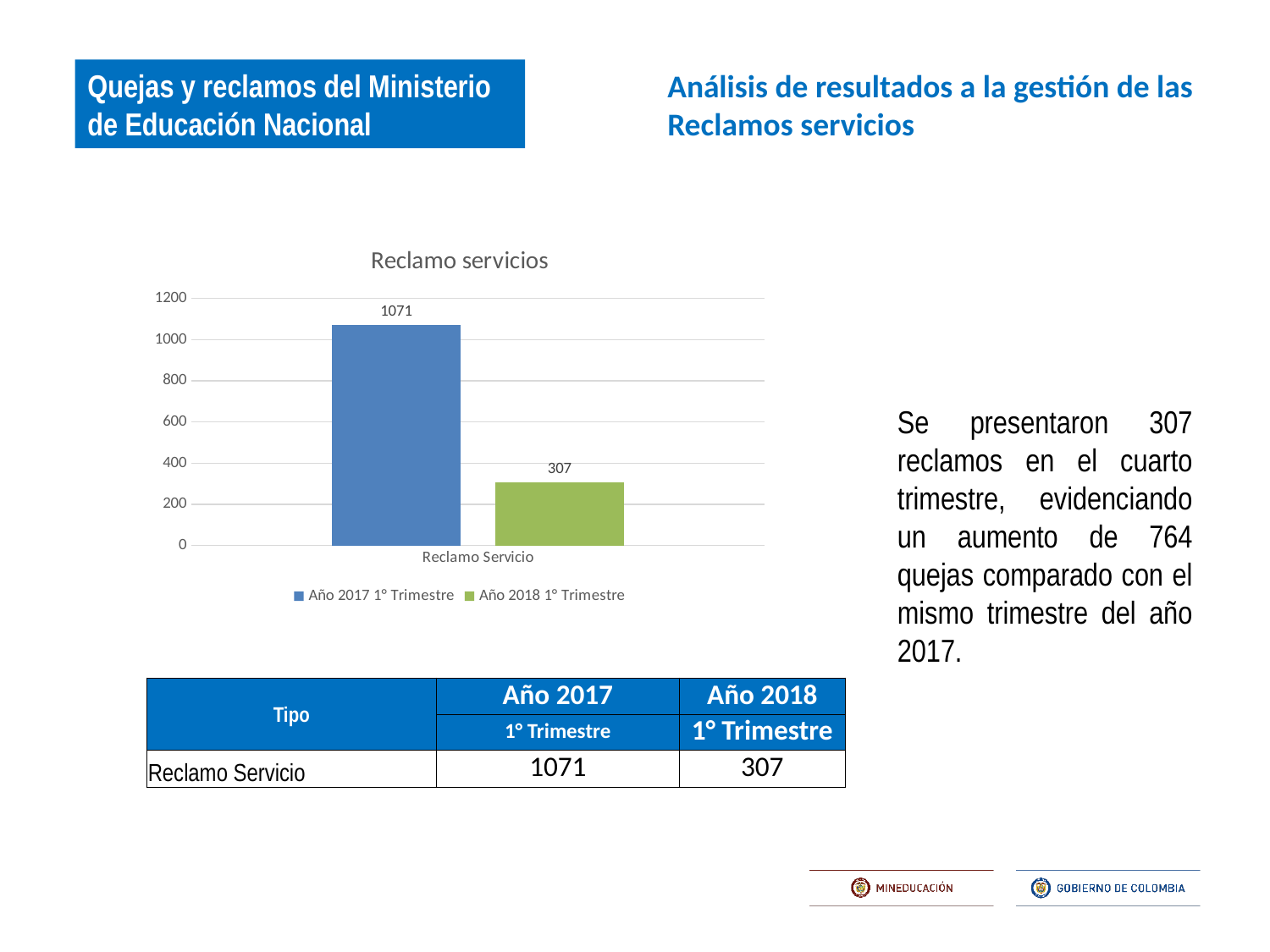
How many categories are shown on the x axis of the chart? 1 Which series has the higher value in the Reclamo servicios chart? Año 2017 1° Trimestre Is the value for Año 2018 1° Trimestre greater or less than 400? less Is the value for Año 2017 1° Trimestre larger or smaller than the value for Año 2018 1° Trimestre? larger What is the value for Año 2018 1° Trimestre in the Reclamo servicios chart? 307 How many series does the legend of the chart list? 2 What is the difference between the Año 2017 1° Trimestre and Año 2018 1° Trimestre values in the chart? 764 What kind of chart is shown on the slide? bar chart Is the value for Año 2017 1° Trimestre greater or less than 1000? greater What is the value for Año 2017 1° Trimestre in the Reclamo servicios chart? 1071 Which series has the lower value in the Reclamo servicios chart? Año 2018 1° Trimestre What is the title of the chart? Reclamo servicios